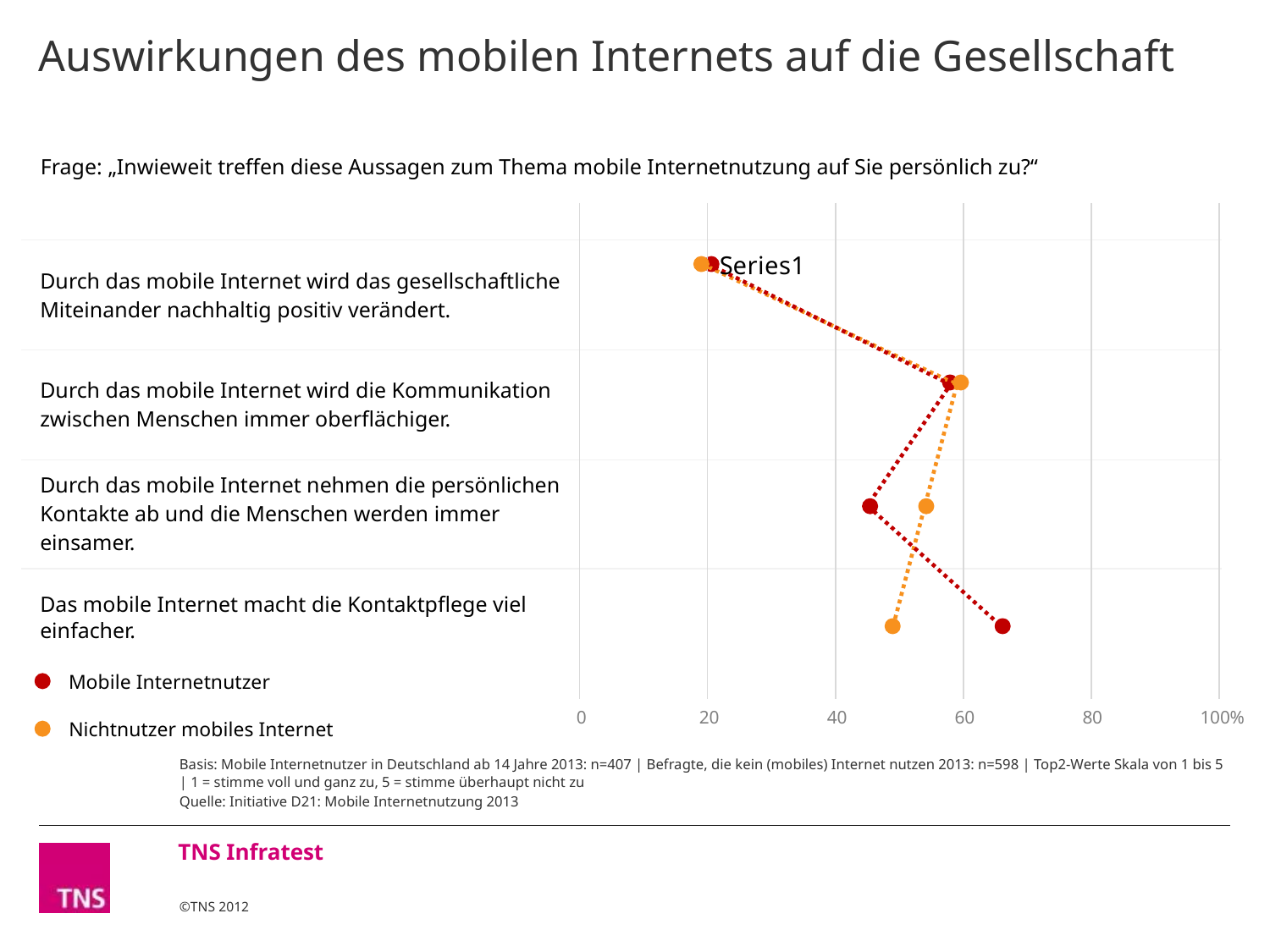
What colour is used for the Mobile Internetnutzer series in the legend? red Is the value for Mobile Internetnutzer on "Durch das mobile Internet wird das gesellschaftliche Miteinander nachhaltig positiv verändert." greater or less than 40? less What kind of chart is shown on the slide? line chart Which statement has the highest value for Mobile Internetnutzer? Das mobile Internet macht die Kontaktpflege viel einfacher. Which statement has the lowest value for Nichtnutzer mobiles Internet? Durch das mobile Internet wird das gesellschaftliche Miteinander nachhaltig positiv verändert. For "Das mobile Internet macht die Kontaktpflege viel einfacher.", which series has the larger value, Mobile Internetnutzer or Nichtnutzer mobiles Internet? Mobile Internetnutzer For "Durch das mobile Internet nehmen die persönlichen Kontakte ab und die Menschen werden immer einsamer.", which series has the larger value, Mobile Internetnutzer or Nichtnutzer mobiles Internet? Nichtnutzer mobiles Internet Is the value for Nichtnutzer mobiles Internet on "Durch das mobile Internet nehmen die persönlichen Kontakte ab und die Menschen werden immer einsamer." greater or less than 40? greater Is the value for Mobile Internetnutzer on "Das mobile Internet macht die Kontaktpflege viel einfacher." greater or less than 60? greater How many statements (categories) are plotted in the chart? 4 How many series does the legend list? 2